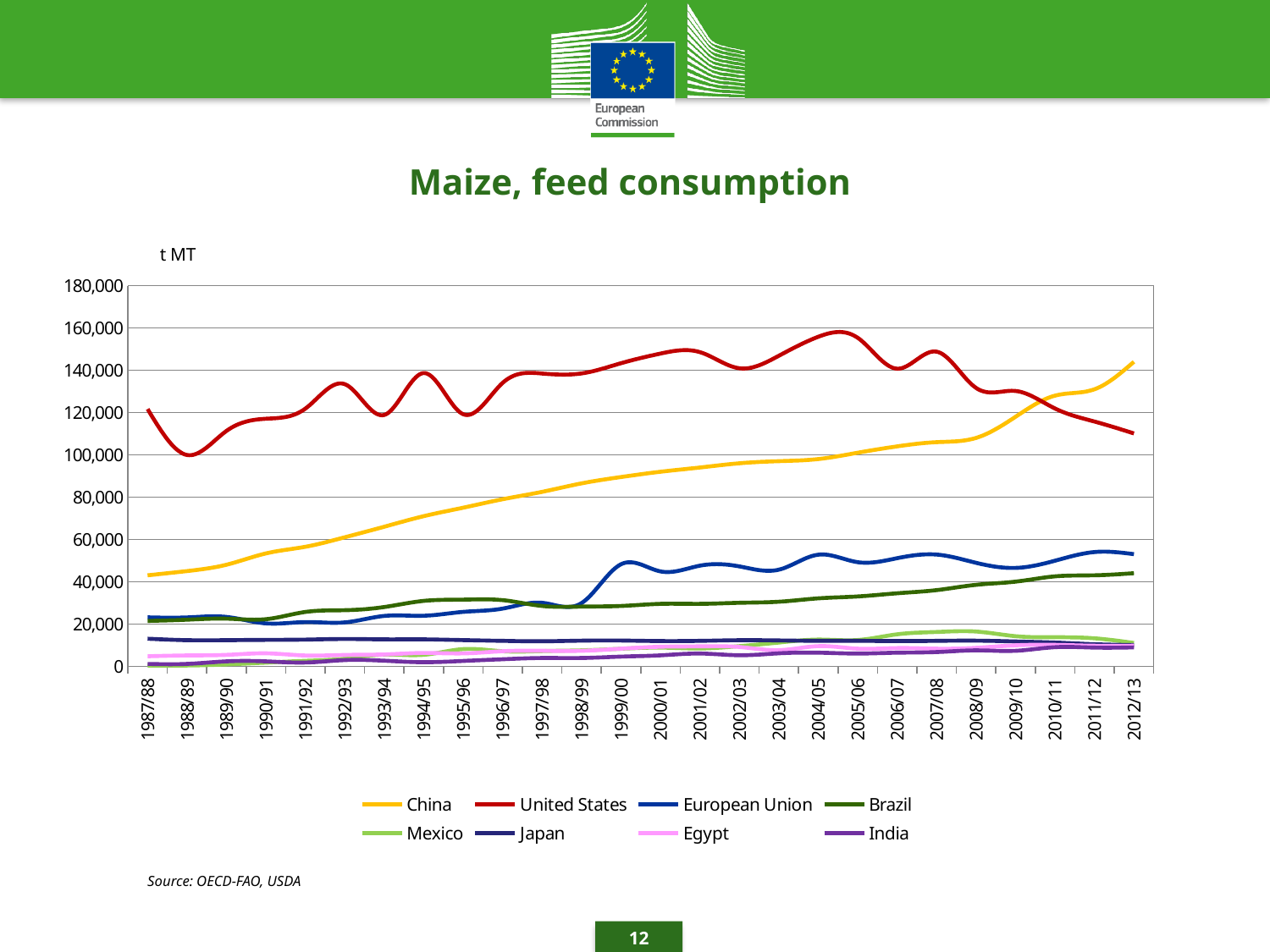
How many marketing years are shown along the x axis? 26 In 2012/13, which is larger: maize feed consumption in China or in the United States? China Does maize feed consumption in China rise or fall from 1987/88 to 2012/13? rise What kind of chart is shown on the slide? line chart Which country has the lowest maize feed consumption in 1987/88? Mexico What unit is shown on the y axis of the chart? t MT How many series does the legend list? 8 Is the value for Japan in 2012/13 greater or less than 20,000? less In 1987/88, which is larger: maize feed consumption in the United States or in China? United States Is the value for the United States in 2004/05 greater or less than 140,000? greater Which country or region has the highest maize feed consumption in 2012/13? China Is the value for China in 2000/01 greater or less than 80,000? greater